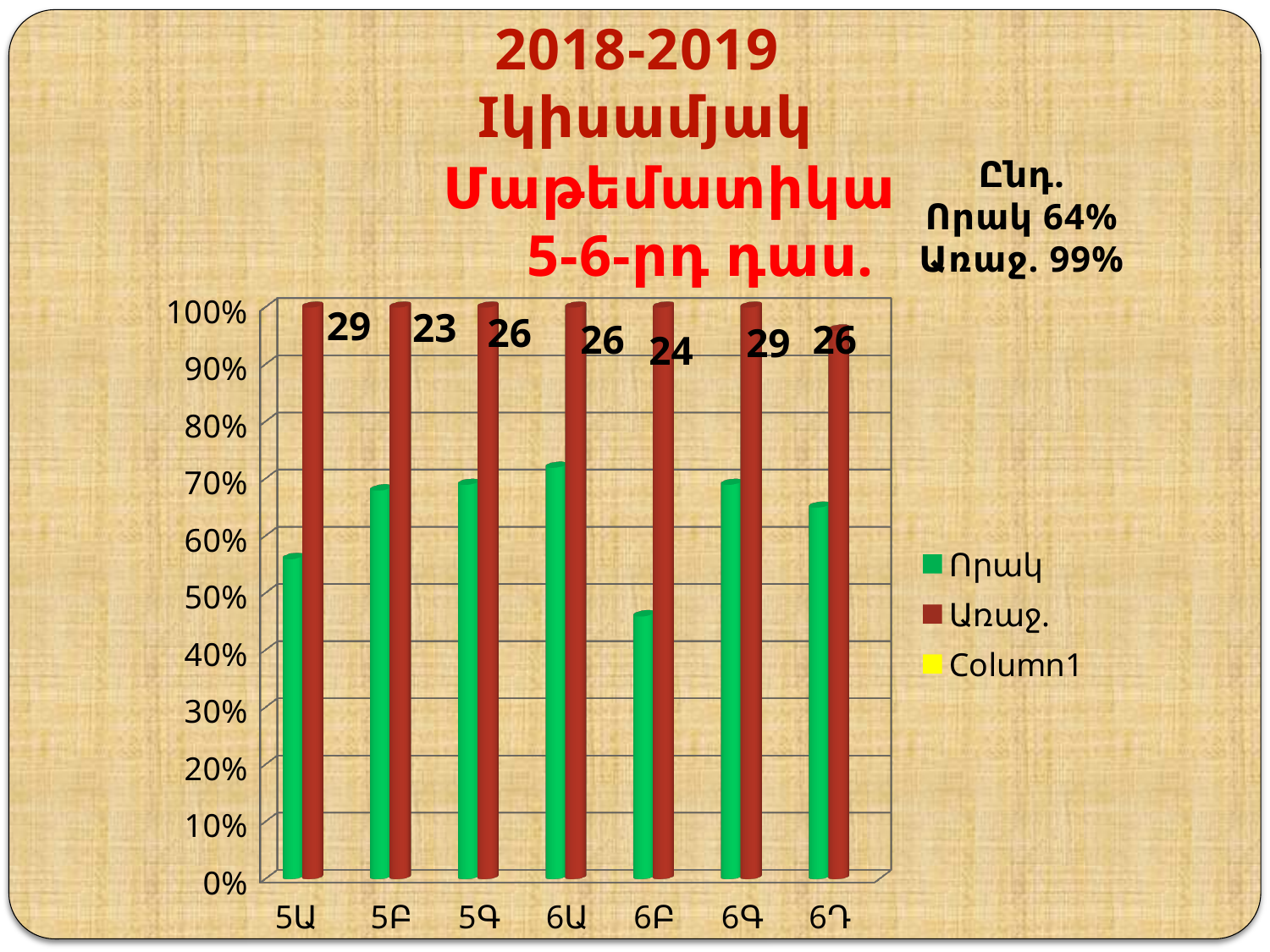
What kind of chart is shown on the slide? bar chart Is the Որակ value for 6Բ greater or less than 50%? less How many categories are shown on the x axis? 7 Which is larger, the Որակ value for 5Ա or for 5Բ? 5Բ Which category has the lowest value for the Որակ series? 6Բ Is the Որակ value for 6Դ greater or less than 70%? less What number is printed next to the Առաջ. bar for 5Բ? 23 How many series does the legend list? 3 Which series is shown in green in the legend? Որակ Which is larger, the Որակ value for 6Ա or for 6Բ? 6Ա Is the Որակ value for 5Ա greater or less than 50%? greater